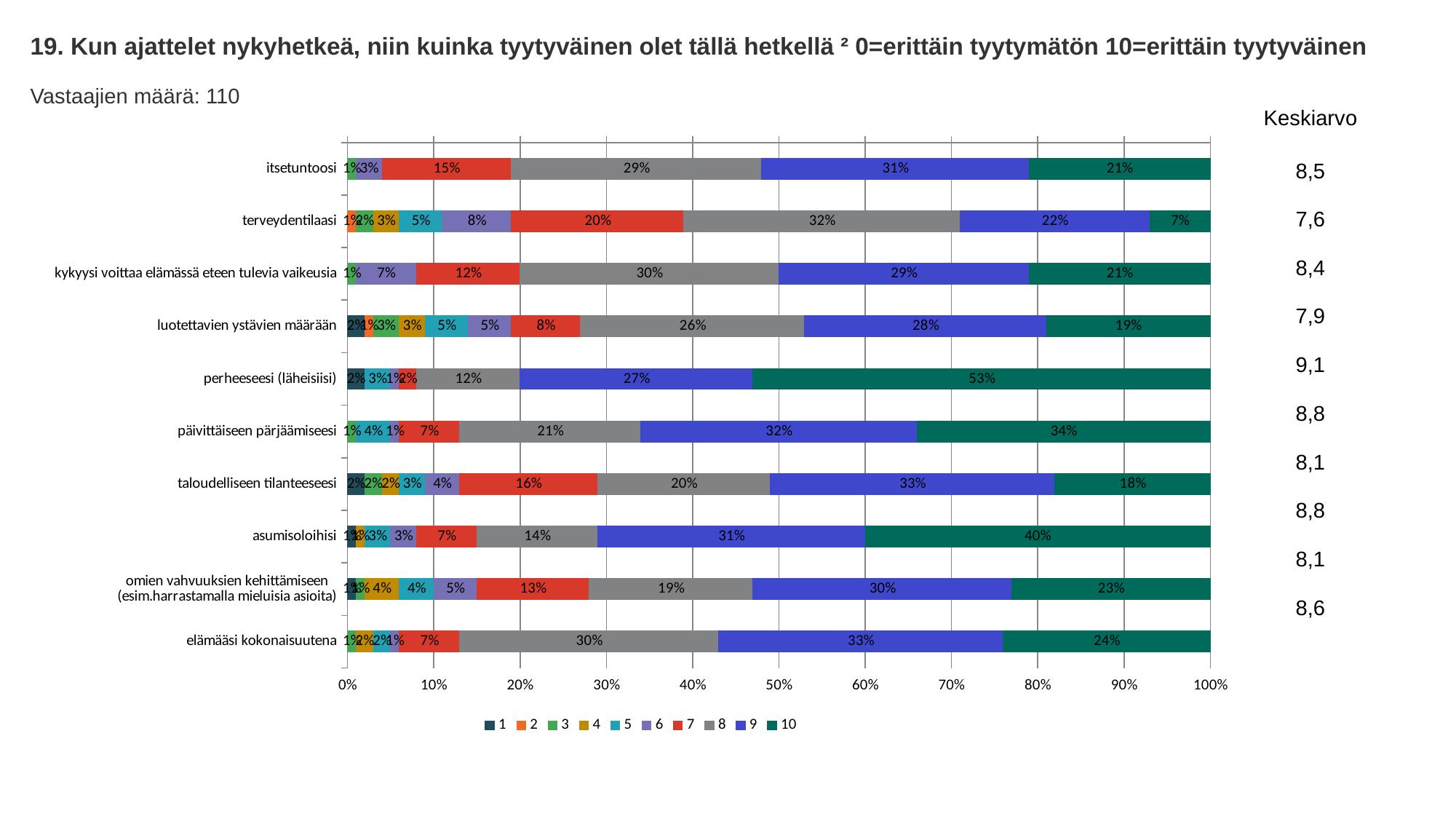
What is the Keskiarvo (mean) shown for "terveydentilaasi"? 7,6 How many categories are shown on the chart? 10 Which category has the lowest share of respondents giving a rating of 10? terveydentilaasi What percentage of respondents gave a rating of 7 for "itsetuntoosi"? 15% What kind of chart is shown on the slide? Stacked bar chart Which has a larger share of respondents rating 8: "itsetuntoosi" or "terveydentilaasi"? terveydentilaasi What percentage of respondents gave a rating of 8 for "terveydentilaasi"? 32% What is the difference in percentage points between the share rating 10 for "perheeseesi (läheisiisi)" and for "päivittäiseen pärjäämiseesi"? 19 percentage points Which category has the highest share of respondents giving a rating of 10? perheeseesi (läheisiisi) What percentage of respondents gave a rating of 9 for "elämääsi kokonaisuutena"? 33% What percentage of respondents gave a rating of 10 for "perheeseesi (läheisiisi)"? 53% How many series does the legend list? 10